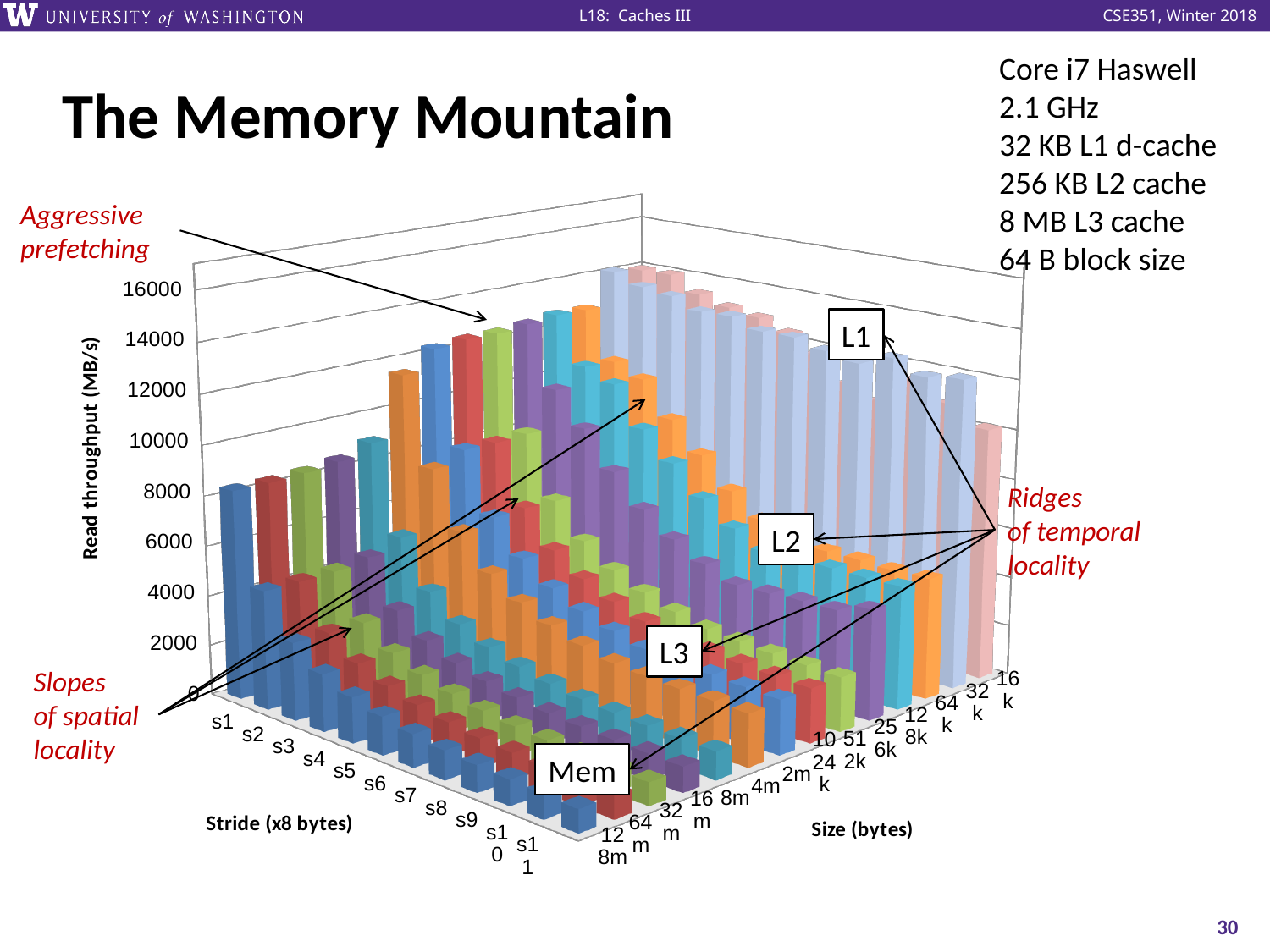
How many stride categories (s1, s2, ...) are plotted on the stride axis? 11 For a fixed size, does read throughput generally rise or fall as the stride increases from s1 to s11? fall Which cache level label is placed at the highest ridge of the chart? L1 Does read throughput generally rise or fall as the working-set size increases from 16k toward the largest sizes? fall What kind of chart is shown on the slide? 3D bar chart What is the label of the vertical axis of the chart? Read throughput (MB/s) What is the highest tick value shown on the read throughput axis? 16000 What is the interval between consecutive ticks on the read throughput axis? 2000 Which labelled region of the chart has the lowest read throughput: L1, L2, L3 or Mem? Mem What is the label of the axis with categories s1 through s11? Stride (x8 bytes)